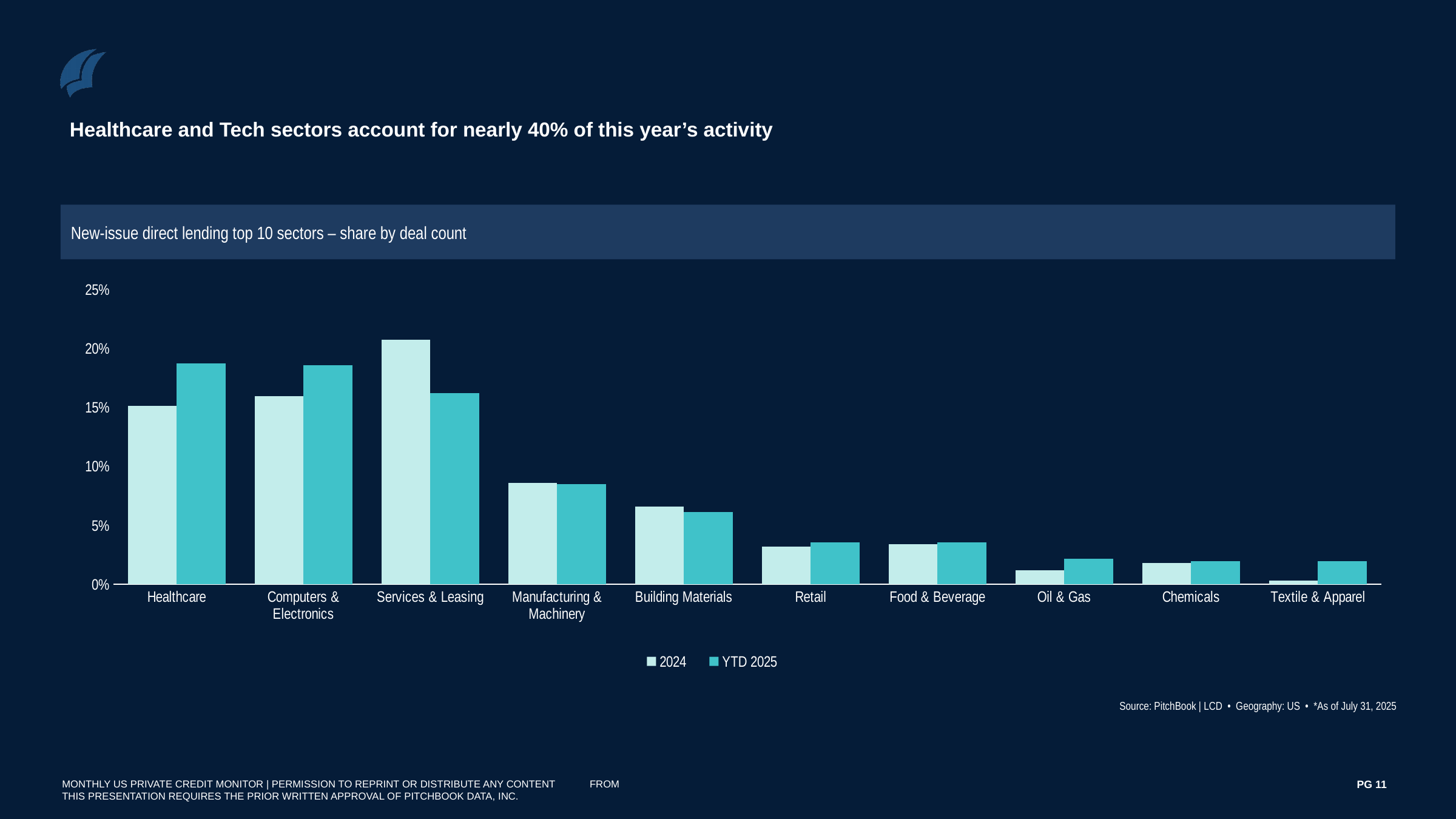
Is the YTD 2025 value for Oil & Gas greater or less than 5%? less Is the 2024 value for Services & Leasing greater or less than 15%? greater For Healthcare, which is larger: the 2024 value or the YTD 2025 value? YTD 2025 Which sector has the highest 2024 share by deal count? Services & Leasing How many sectors are shown on the x axis of the chart? 10 How many series does the chart's legend list? 2 What kind of chart is shown on the slide? Bar chart For Services & Leasing, which is larger: the 2024 value or the YTD 2025 value? 2024 Is the 2024 value for Manufacturing & Machinery greater or less than 10%? less What is the title of the chart? New-issue direct lending top 10 sectors – share by deal count Which sector has the lowest 2024 share by deal count? Textile & Apparel